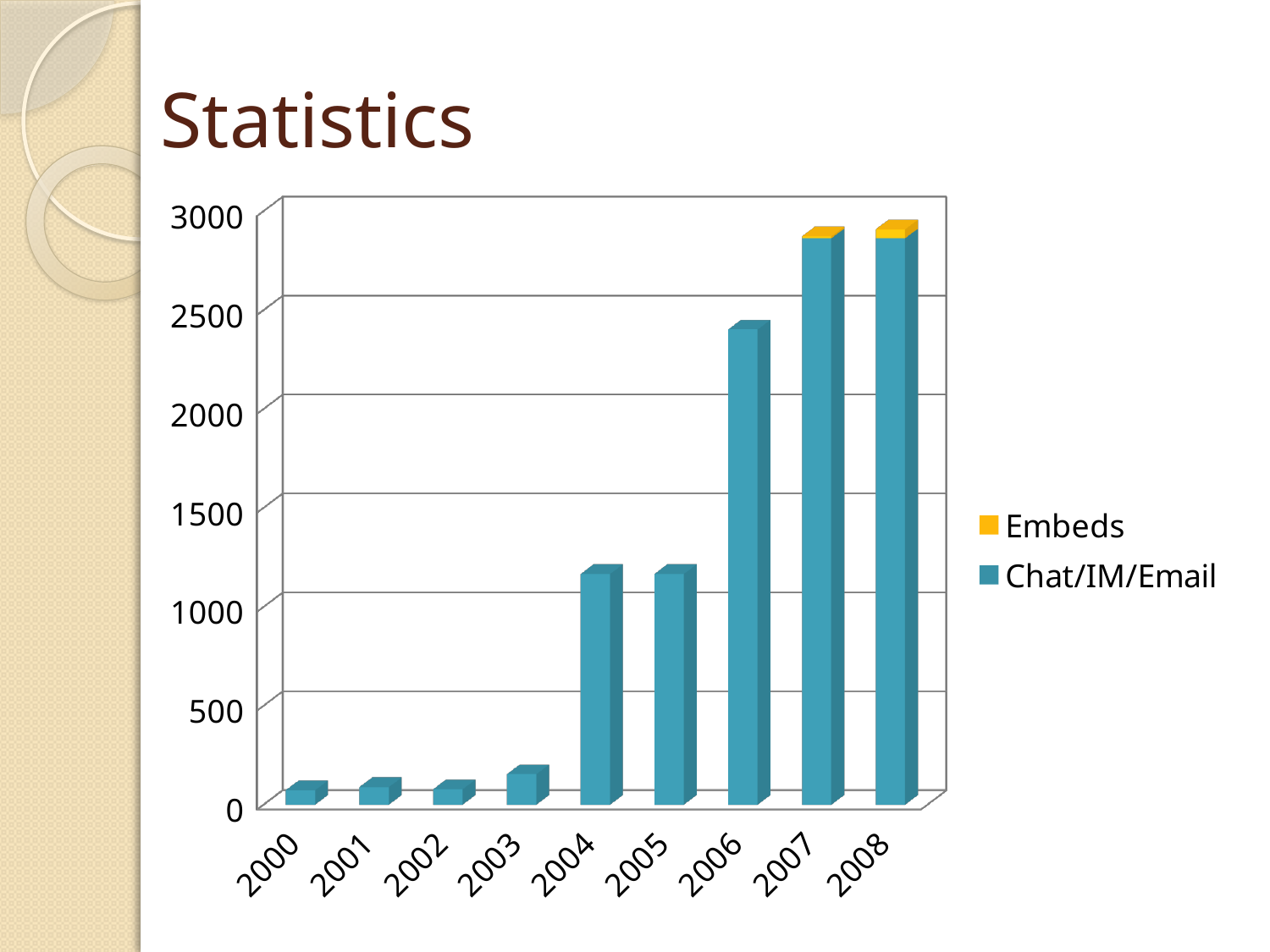
Is the Chat/IM/Email value for 2004 greater or less than 1000? greater Do the bar totals generally rise or fall from 2000 to 2008? rise Is the Chat/IM/Email value for 2007 greater or less than 2500? greater Which two series are listed in the chart's legend? Embeds and Chat/IM/Email How many years are shown on the x axis of the chart? 9 What kind of chart is shown on the slide? bar chart Which year has the larger Chat/IM/Email value, 2003 or 2005? 2005 What is the title of the slide containing the chart? Statistics Is the Chat/IM/Email value for 2003 greater or less than 500? less How many series does the chart's legend list? 2 Which year has the larger Chat/IM/Email value, 2004 or 2006? 2006